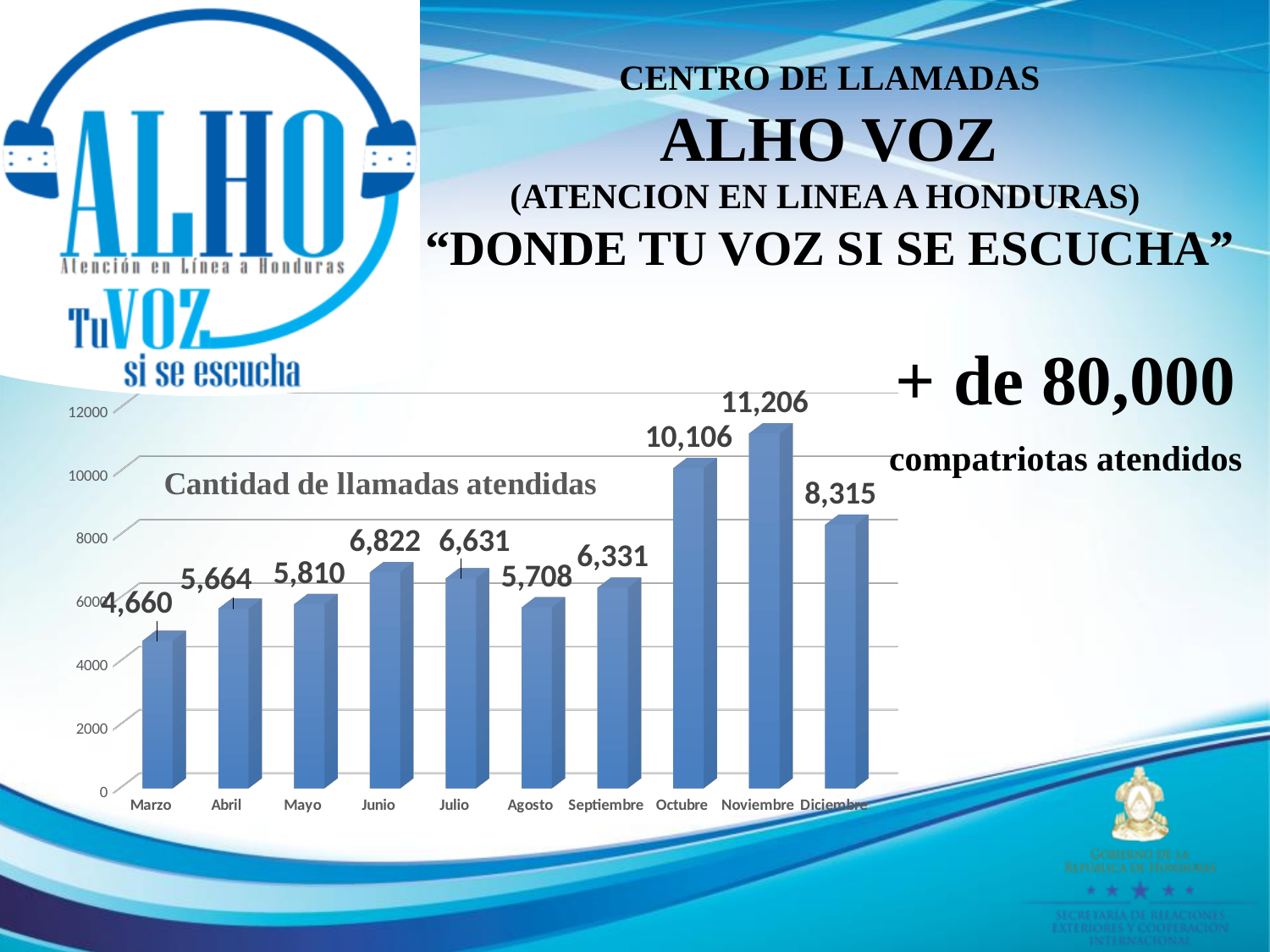
What is the difference between the values for Diciembre and Marzo? 3,655 What is the value for Octubre? 10,106 What type of chart is shown on the slide? bar chart What is the title of the chart? Cantidad de llamadas atendidas What is the value for Diciembre? 8,315 What is the value for Marzo? 4,660 Which month has the highest value? Noviembre Which is larger, the value for Junio or the value for Julio? Junio What is the difference between the values for Noviembre and Octubre? 1,100 Which month has the lowest value? Marzo Is the value for Agosto greater or less than 6000? less How many months are shown on the x axis of the chart? 10